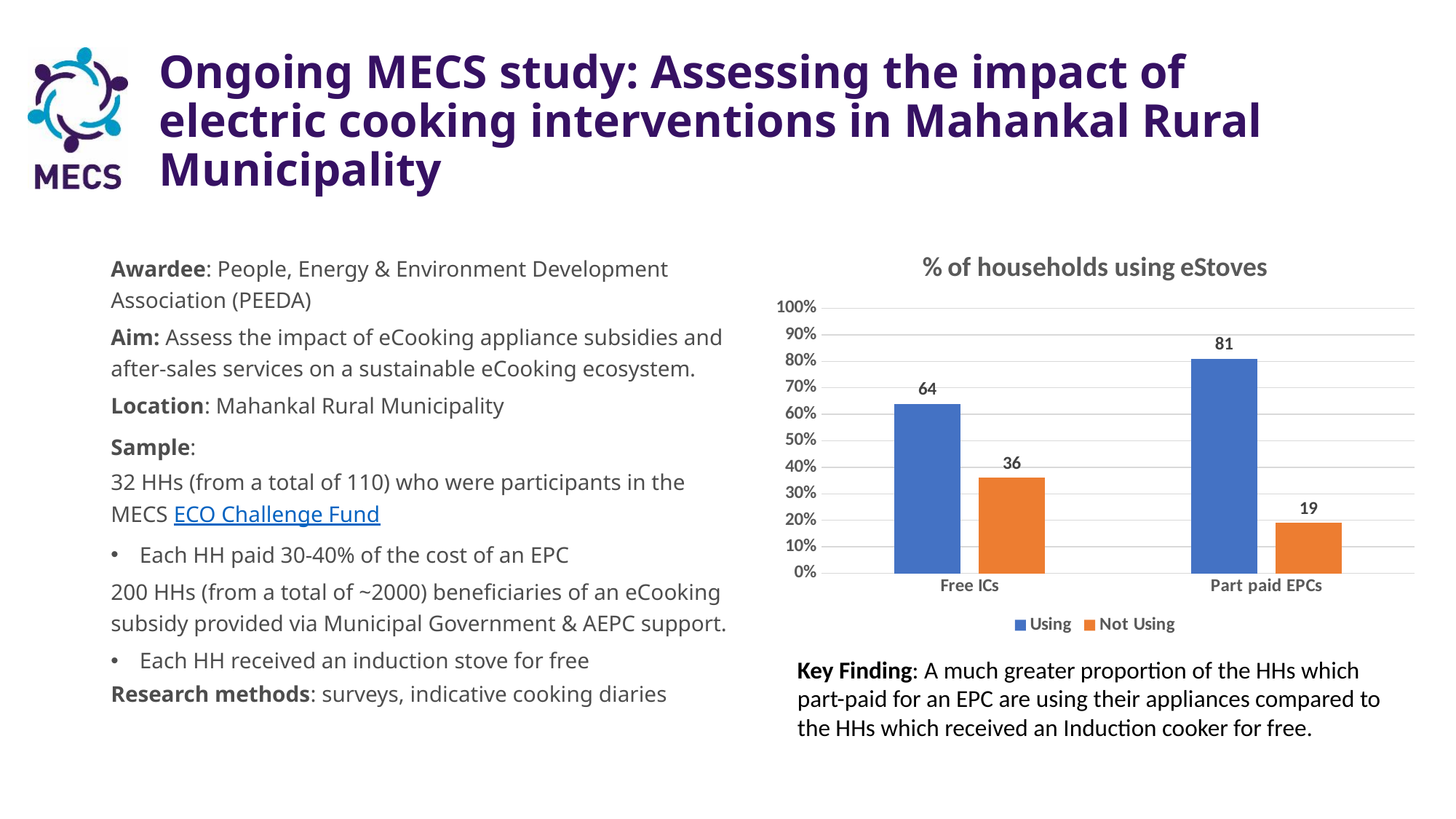
What is the title of the chart? % of households using eStoves Which is larger: the Not Using value for Free ICs or the Not Using value for Part paid EPCs? Free ICs What is the difference between the Using values for Part paid EPCs and Free ICs? 17 Which category has the lowest Not Using value? Part paid EPCs Which category has the highest Using value? Part paid EPCs What is the value for Using in the Free ICs category? 64 What is the value for Not Using in the Part paid EPCs category? 19 How many series does the legend list? 2 How many categories are shown on the x axis? 2 What is the value for Not Using in the Free ICs category? 36 Is the Using value for Part paid EPCs greater or less than 70%? greater What kind of chart is shown on the slide? bar chart